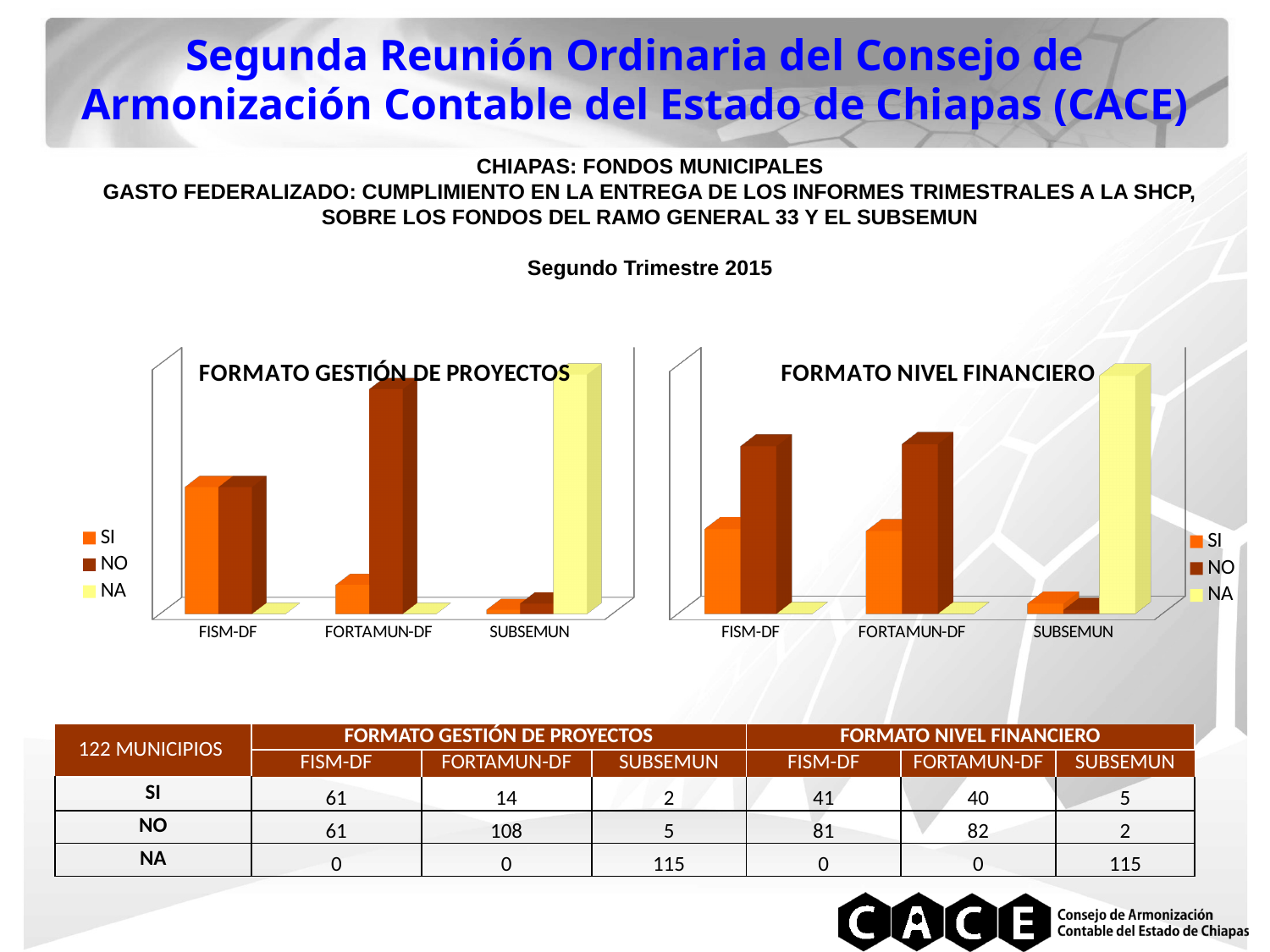
How many series does the legend of the FORMATO NIVEL FINANCIERO chart list? 3 In the FORMATO NIVEL FINANCIERO chart, which category has the lowest SI bar? SUBSEMUN How many categories are shown on the x axis of the FORMATO GESTIÓN DE PROYECTOS chart? 3 In the FORMATO GESTIÓN DE PROYECTOS chart, what is the NO value for FORTAMUN-DF? 108 What kind of chart is the FORMATO GESTIÓN DE PROYECTOS chart? bar chart In the FORMATO NIVEL FINANCIERO chart, what is the NA value for SUBSEMUN? 115 In the FORMATO GESTIÓN DE PROYECTOS chart, which category has the tallest NO bar? FORTAMUN-DF In the FORMATO NIVEL FINANCIERO chart, for FISM-DF, is the SI bar or the NO bar taller? NO In the FORMATO GESTIÓN DE PROYECTOS chart, what is the total of SI, NO and NA for FISM-DF? 122 What are the legend entries of the FORMATO GESTIÓN DE PROYECTOS chart? SI, NO, NA In the FORMATO GESTIÓN DE PROYECTOS chart, what is the difference between the NO and SI values for FORTAMUN-DF? 94 In the FORMATO NIVEL FINANCIERO chart, what is the SI value for FISM-DF? 41